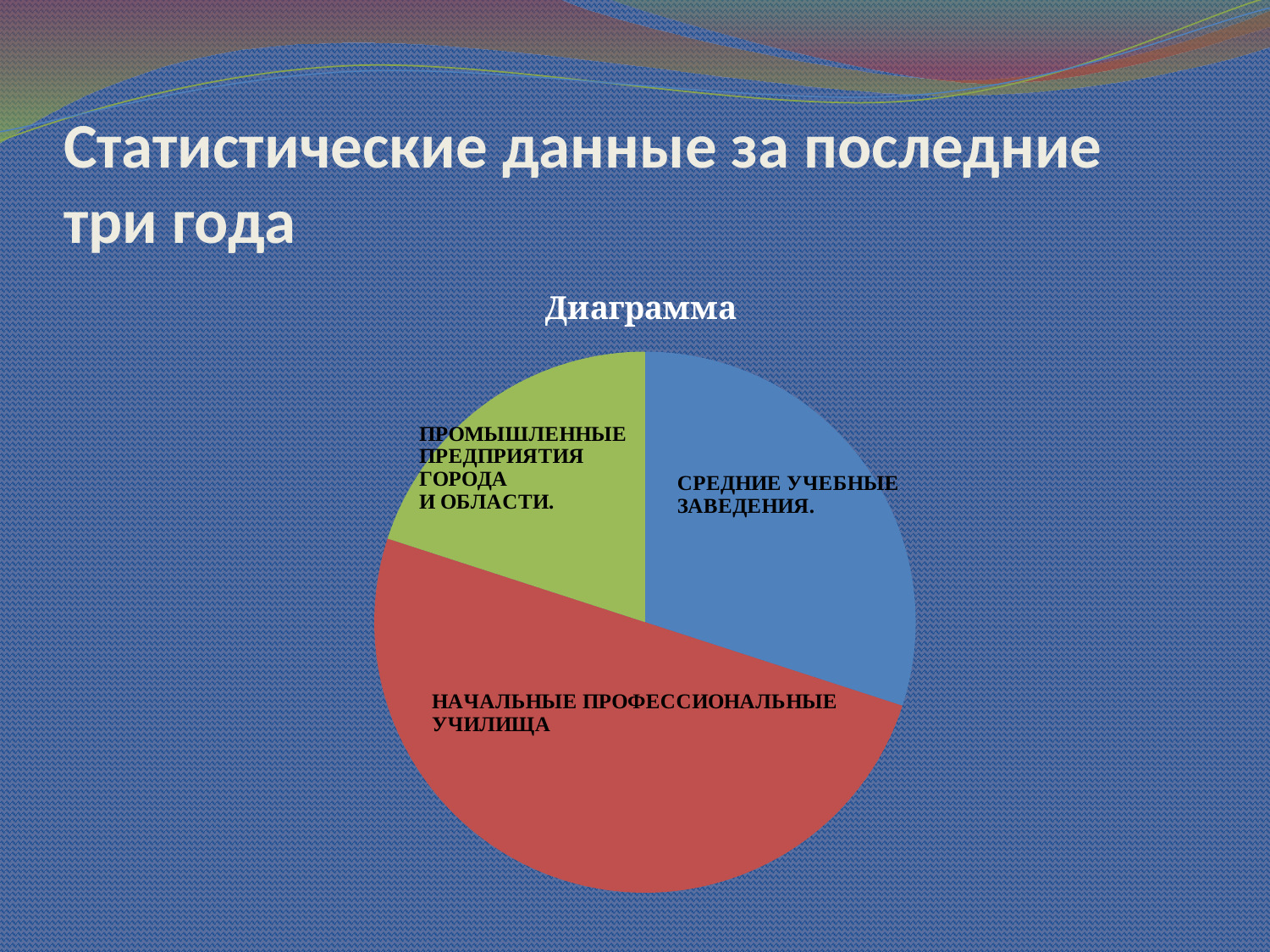
What is the title of the chart? Диаграмма Which category has the smallest slice of the pie chart? ПРОМЫШЛЕННЫЕ ПРЕДПРИЯТИЯ ГОРОДА И ОБЛАСТИ What kind of chart is shown on the slide? pie chart Which slice is larger: НАЧАЛЬНЫЕ ПРОФЕССИОНАЛЬНЫЕ УЧИЛИЩА or СРЕДНИЕ УЧЕБНЫЕ ЗАВЕДЕНИЯ? НАЧАЛЬНЫЕ ПРОФЕССИОНАЛЬНЫЕ УЧИЛИЩА Which category has the largest slice of the pie chart? НАЧАЛЬНЫЕ ПРОФЕССИОНАЛЬНЫЕ УЧИЛИЩА What colour is the slice for СРЕДНИЕ УЧЕБНЫЕ ЗАВЕДЕНИЯ? blue How many slices does the pie chart have? 3 Which slice is larger: СРЕДНИЕ УЧЕБНЫЕ ЗАВЕДЕНИЯ or ПРОМЫШЛЕННЫЕ ПРЕДПРИЯТИЯ ГОРОДА И ОБЛАСТИ? СРЕДНИЕ УЧЕБНЫЕ ЗАВЕДЕНИЯ